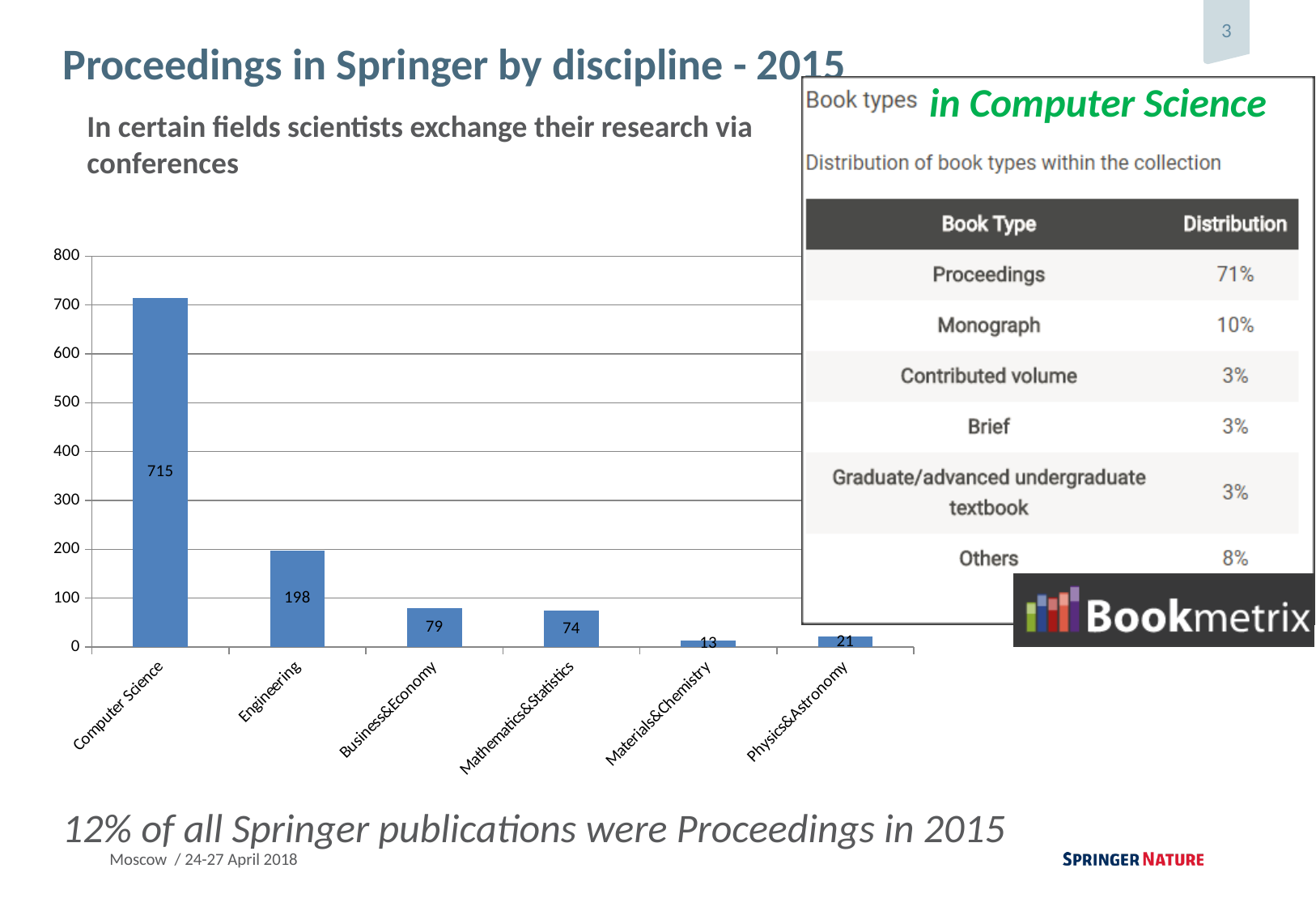
What kind of chart is used to show proceedings by discipline? bar chart Is the value for Engineering in the bar chart greater or less than 300? less Which discipline has the highest value in the bar chart? Computer Science What is the value for Materials&Chemistry in the bar chart? 13 What is the title of the slide containing the bar chart? Proceedings in Springer by discipline - 2015 What is the value for Computer Science in the bar chart? 715 What is the value for Engineering in the bar chart? 198 Which discipline has the lowest value in the bar chart? Materials&Chemistry What is the difference between the values for Computer Science and Engineering in the bar chart? 517 What is the difference between the values for Business&Economy and Mathematics&Statistics in the bar chart? 5 How many disciplines are shown in the bar chart? 6 Which is larger in the bar chart, the value for Physics&Astronomy or the value for Materials&Chemistry? Physics&Astronomy